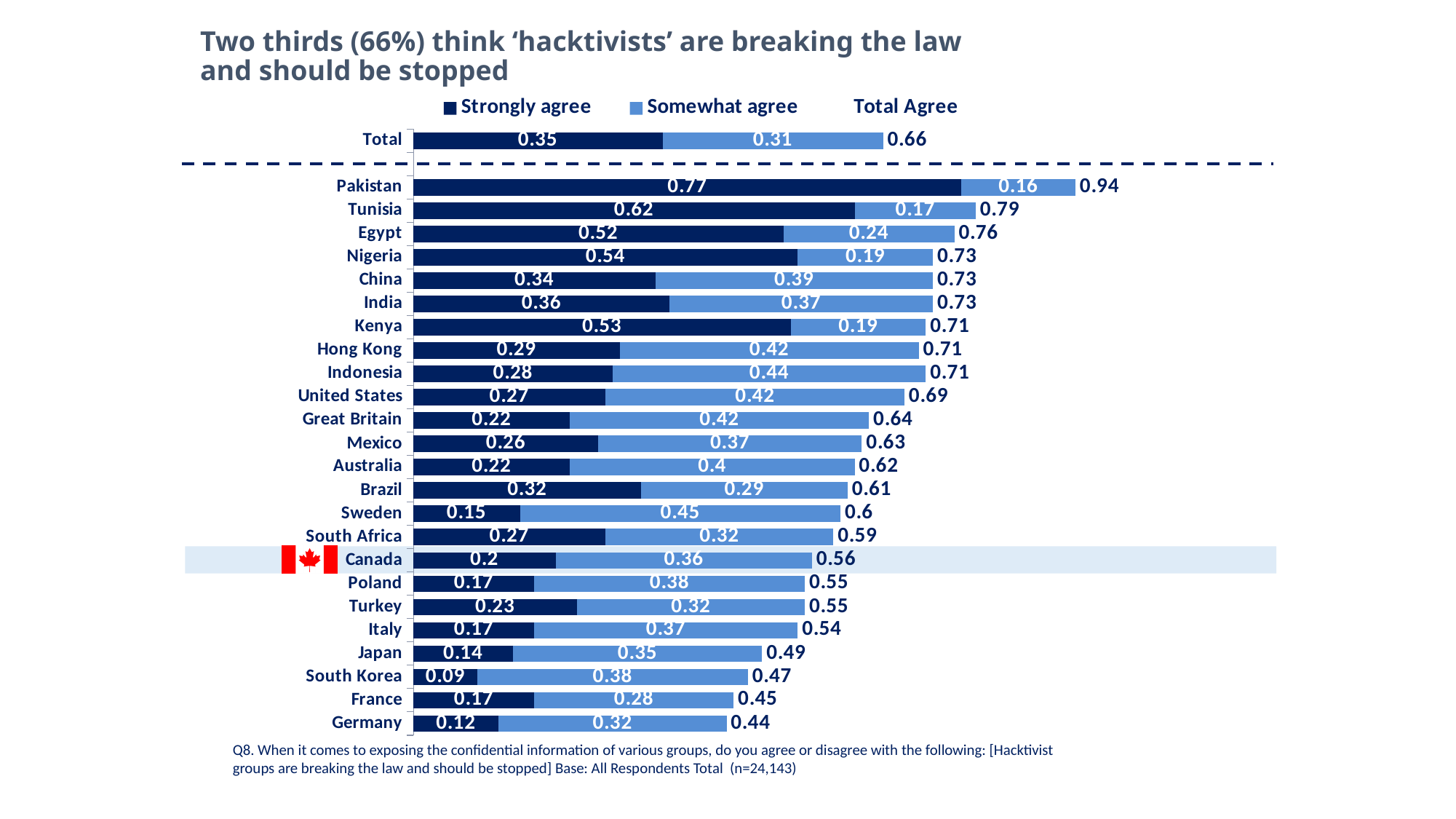
What is the total of the stacked bar for Canada (Strongly agree plus Somewhat agree)? 0.56 What kind of chart is shown on the slide? Stacked bar chart What is the Strongly agree value for Pakistan? 0.77 Which country has the highest Total Agree value? Pakistan Which country has the lowest Total Agree value? Germany What is the Somewhat agree value for Canada? 0.36 What is the difference between the Total Agree values for Pakistan and Germany? 0.5 What is the Total Agree value for Germany? 0.44 Which country has the lowest Strongly agree value? South Korea How many countries are listed below the dashed line in the chart? 24 How many entries does the legend list? 3 Which has the larger Strongly agree value, Egypt or Nigeria? Nigeria